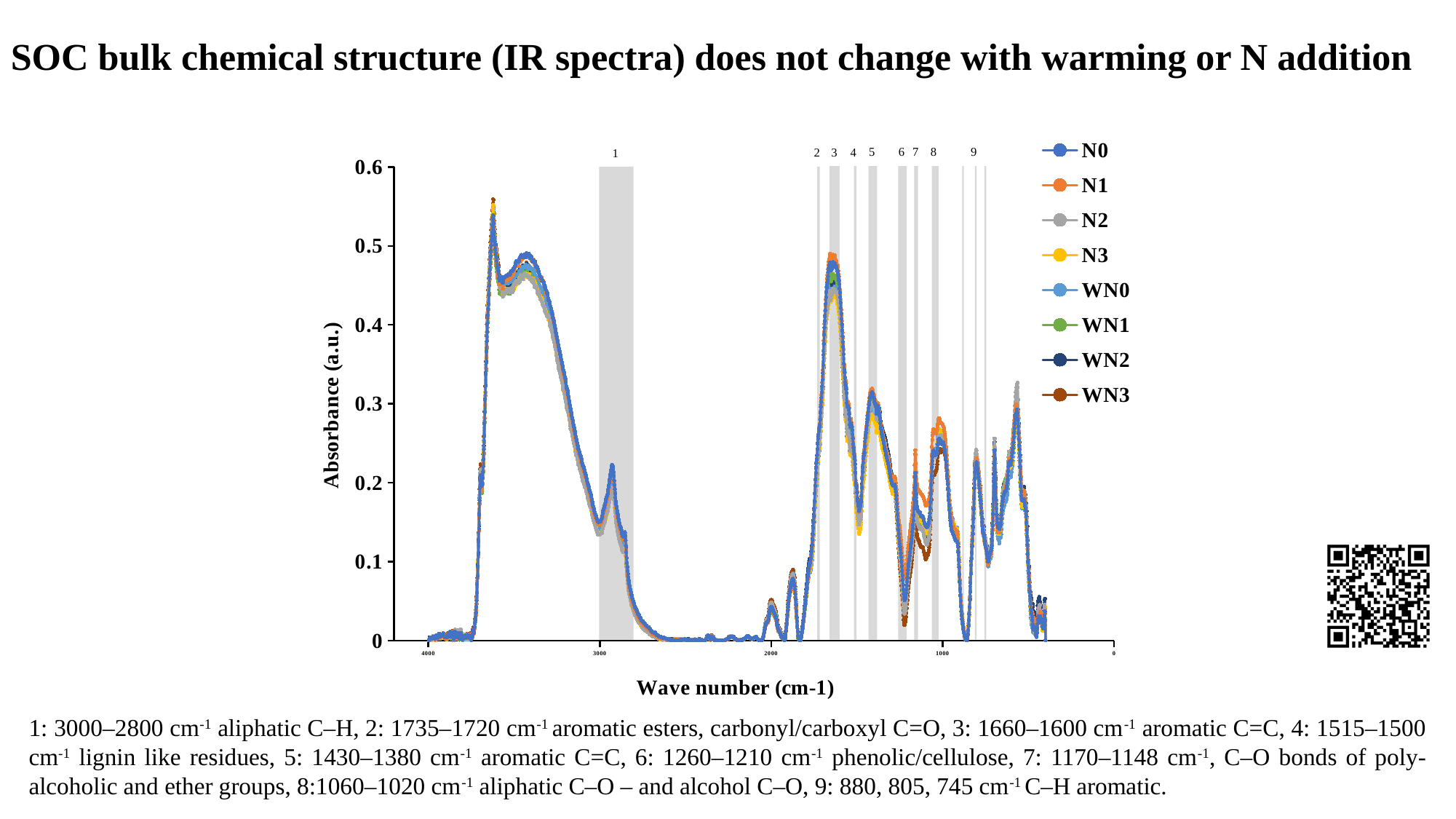
How many series does the legend list? 8 Is the absorbance at the small peak near 2900 cm-1 (band 1) greater or less than 0.3? less Is the absorbance at the peak near 1400 cm-1 (band 5) greater or less than 0.2? greater Is the absorbance at wave number 2500 cm-1 greater or less than 0.1? less Which series is listed last in the legend? WN3 How many numbered shaded bands are marked on the chart? 9 What is the label of the y axis? Absorbance (a.u.) What is the label of the x axis? Wave number (cm-1) What kind of chart is shown on the slide? Line chart